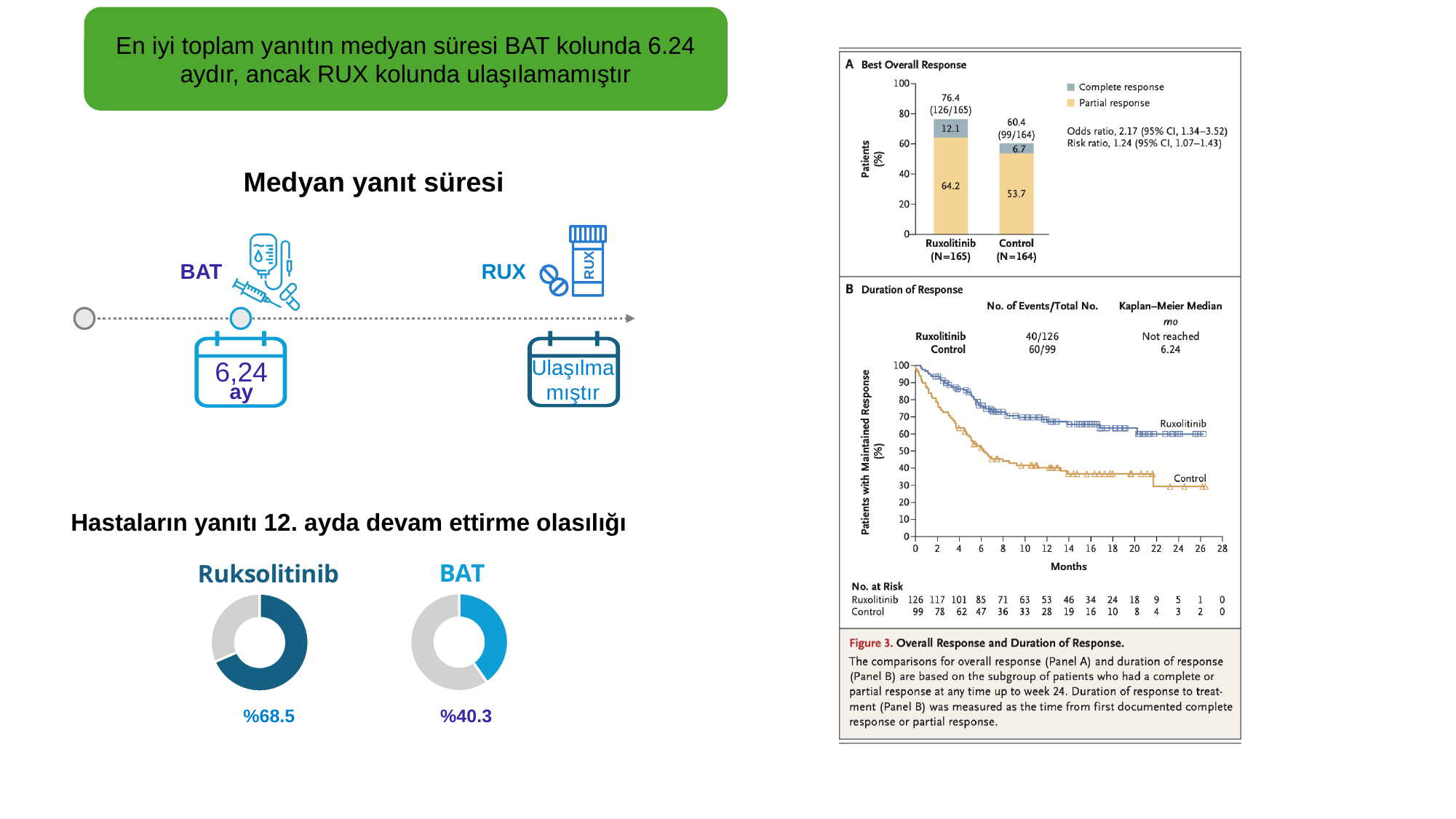
In the 'Duration of Response' chart, is the Control curve at 12 months greater or less than 50%? less How many series does the legend of the 'Best Overall Response' chart list? 2 In the 'Best Overall Response' bar chart, what is the total best overall response percentage for the Ruxolitinib bar? 76.4 In the 'Best Overall Response' bar chart, what is the total best overall response percentage for the Control bar? 60.4 In the 'Best Overall Response' bar chart, what is the difference between the complete response percentages of Ruxolitinib and Control? 5.4 In the 'Duration of Response' chart, how many Ruxolitinib patients were at risk at 0 months? 126 In the 'Best Overall Response' bar chart, what is the partial response percentage for the Ruxolitinib group? 64.2 In the 'Best Overall Response' bar chart, which group has the higher partial response percentage? Ruxolitinib In the 'Best Overall Response' bar chart, what is the complete response percentage for the Control group? 6.7 What kind of chart is Panel A 'Best Overall Response'? Stacked bar chart In the donut charts at the bottom left, what is the value shown for BAT? %40.3 In the 'Duration of Response' chart, what is the Kaplan-Meier median for the Control group? 6.24